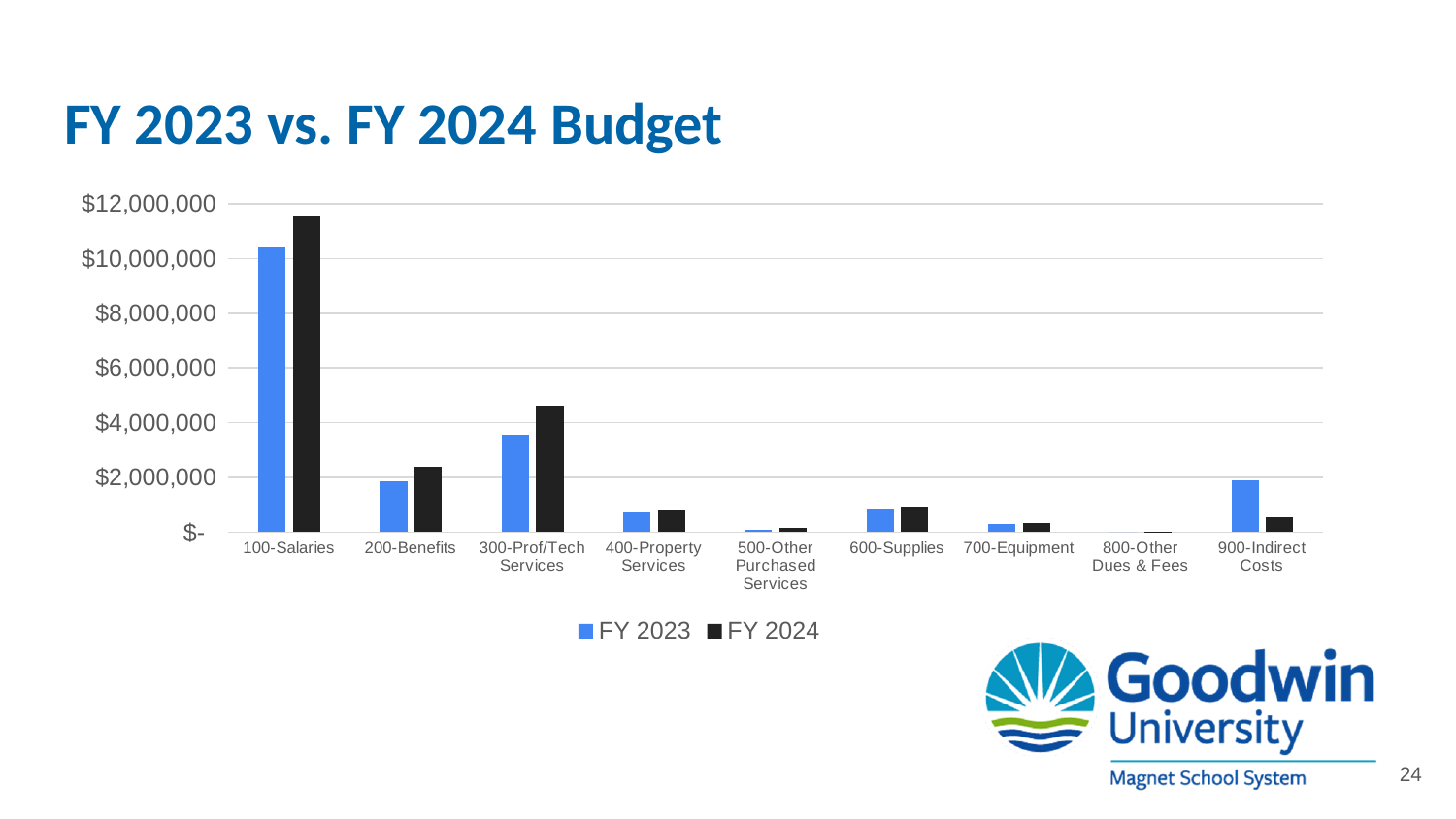
Which category has the lowest FY 2023 value? 800-Other Dues & Fees Is the FY 2023 value for 300-Prof/Tech Services greater or less than $4,000,000? less How many series does the legend list? 2 For 900-Indirect Costs, which is larger: the FY 2023 value or the FY 2024 value? FY 2023 Is the FY 2024 value for 200-Benefits greater or less than $2,000,000? greater For 300-Prof/Tech Services, which is larger: the FY 2023 value or the FY 2024 value? FY 2024 Which category has the highest FY 2024 value? 100-Salaries What is the title of the chart? FY 2023 vs. FY 2024 Budget How many budget categories are shown on the x axis? 9 Is the FY 2024 value for 100-Salaries greater or less than $10,000,000? greater What colour represents the FY 2024 series in the legend? black What kind of chart is shown on the slide? bar chart